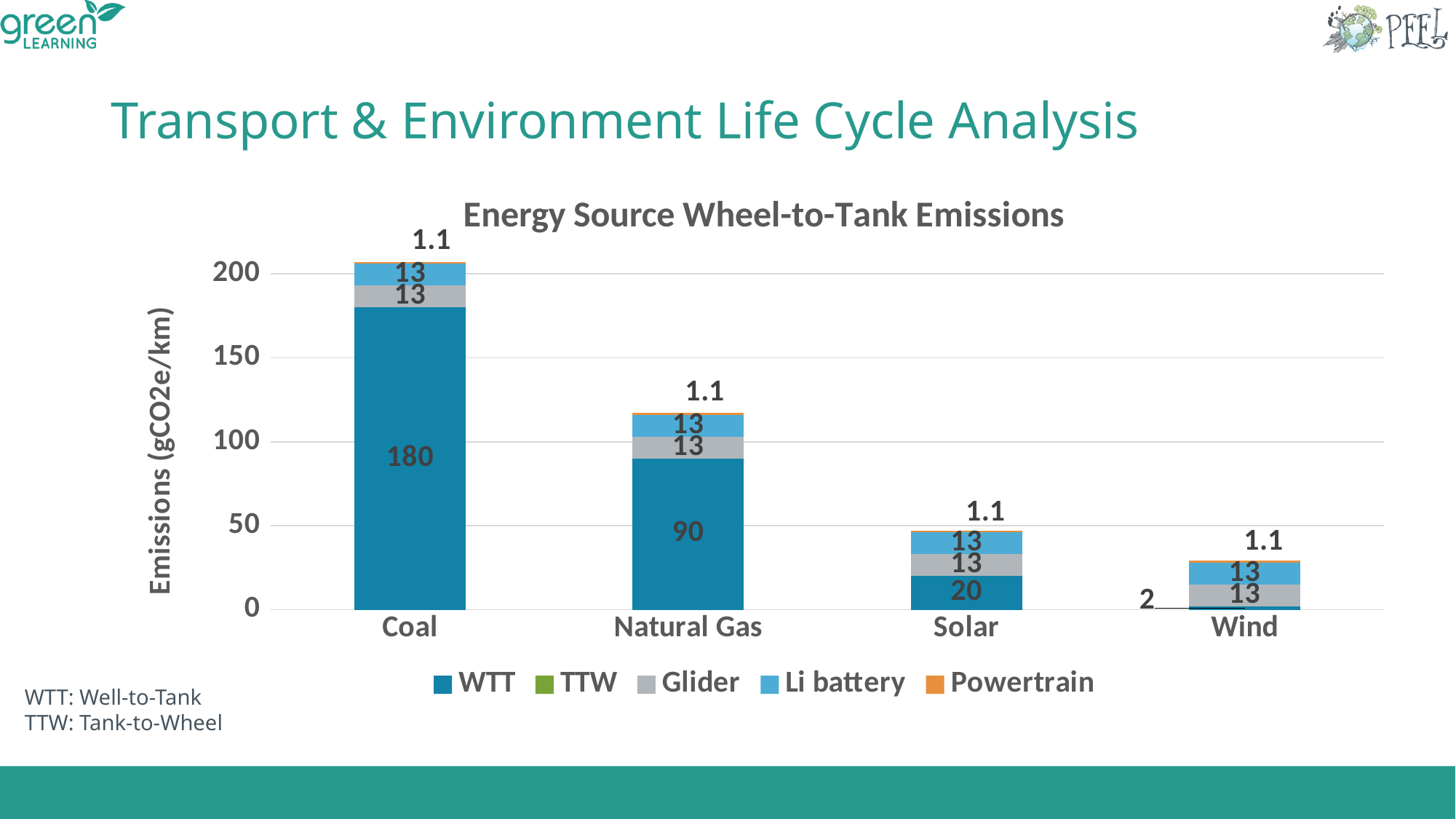
Which has a larger WTT value, Solar or Natural Gas? Natural Gas Which energy source has the lowest WTT emissions? Wind What is the difference between the WTT values for Coal and Natural Gas? 90 What type of chart is shown? Stacked bar chart Which energy source has the highest WTT emissions? Coal Is the total height of the Natural Gas bar greater or less than 100? greater What is the WTT value for Wind? 2 What is the WTT value for Coal? 180 How many energy sources are shown on the x axis? 4 What is the Powertrain value for Solar? 1.1 How many series does the legend list? 5 What is the WTT value for Natural Gas? 90